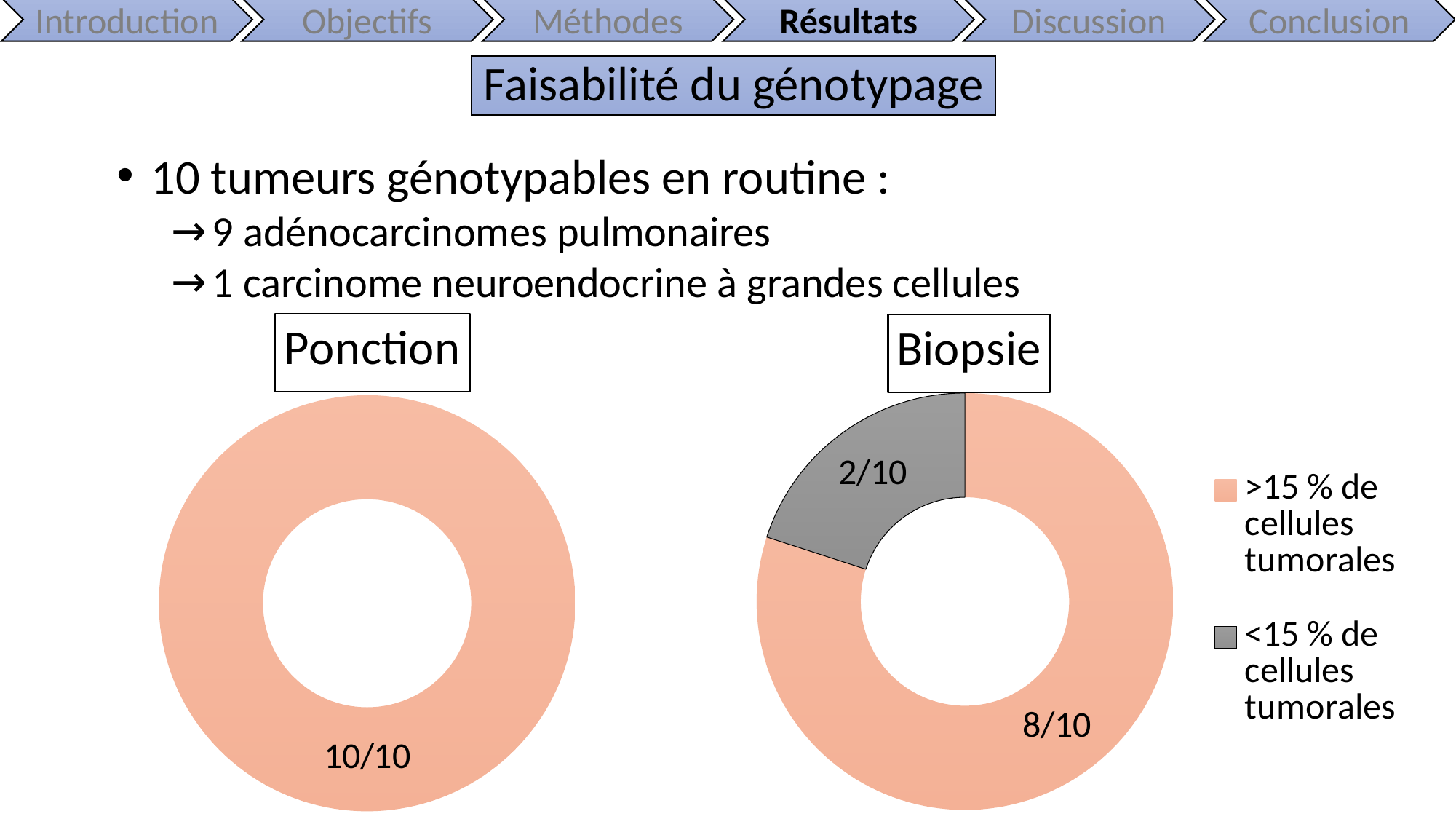
How many slices are visible in the "Ponction" chart? 1 In the "Biopsie" chart, what is the value labelled for the ">15 % de cellules tumorales" slice? 8/10 How many entries does the legend list? 2 What colour represents "<15 % de cellules tumorales" in the legend? grey What is the title of the chart on the left? Ponction In the "Ponction" chart, what value is labelled on the ">15 % de cellules tumorales" slice? 10/10 In the "Biopsie" chart, which category has the largest slice? >15 % de cellules tumorales In the "Biopsie" chart, what is the value labelled for the "<15 % de cellules tumorales" slice? 2/10 In the "Biopsie" chart, which category has the smallest slice? <15 % de cellules tumorales In the "Biopsie" chart, is the ">15 % de cellules tumorales" slice larger or smaller than the "<15 % de cellules tumorales" slice? larger How many slices are visible in the "Biopsie" chart? 2 What kind of chart is the "Ponction" chart? doughnut chart